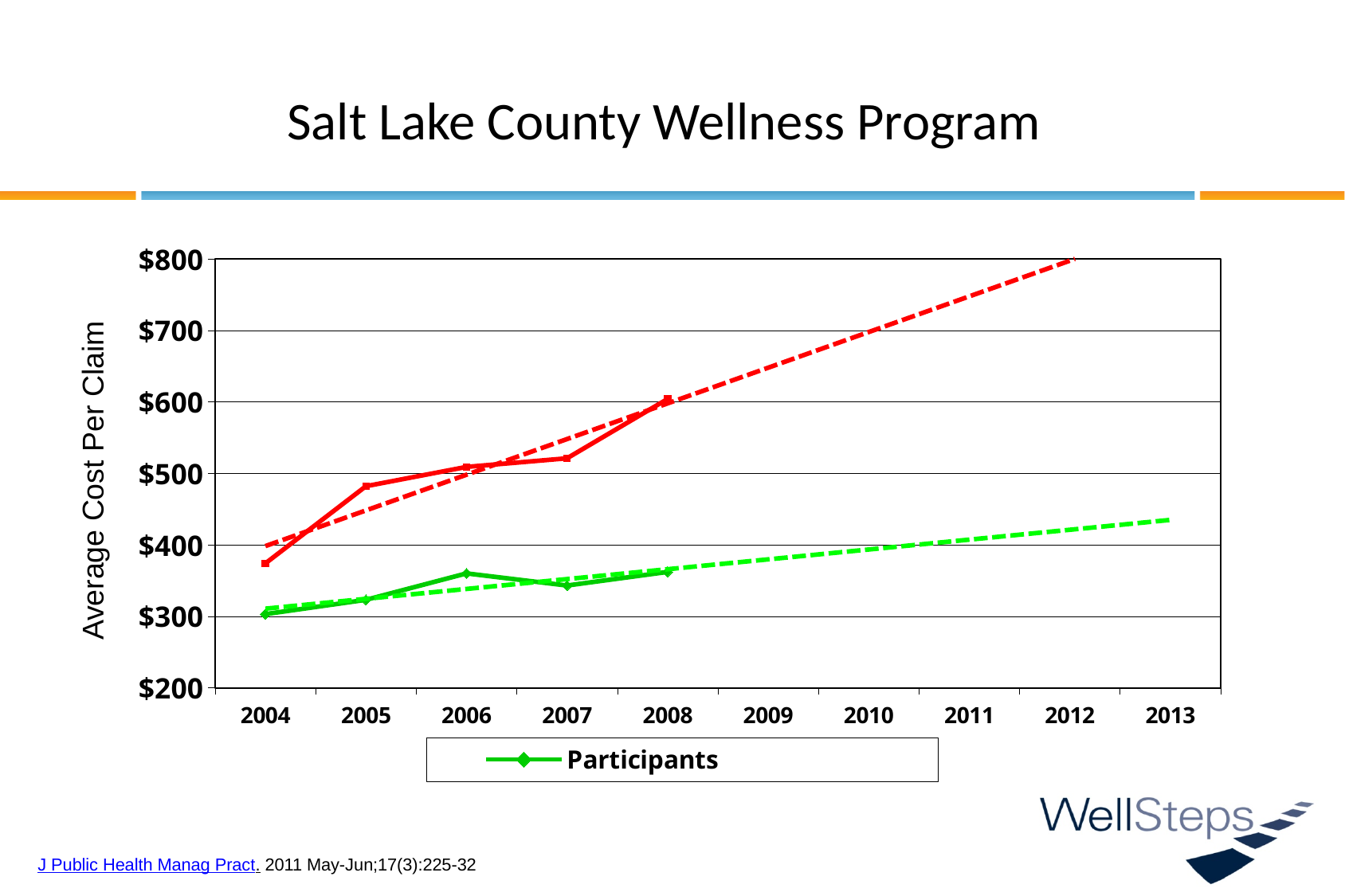
Is the Participants value for 2006 greater or less than $300? greater How many data points are plotted for the Participants series (solid green line)? 5 What is the title of the vertical axis? Average Cost Per Claim What kind of chart is shown on the slide? line chart How many years are labelled on the x axis? 10 How many series does the legend list? 1 What is the label of the series listed in the legend? Participants Is the value of the red solid line for 2004 greater or less than $400? less Is the Participants value for 2004 greater or less than $400? less In which year is the red solid line at its lowest? 2004 In 2008, which is larger: the red solid line or the Participants line? the red solid line